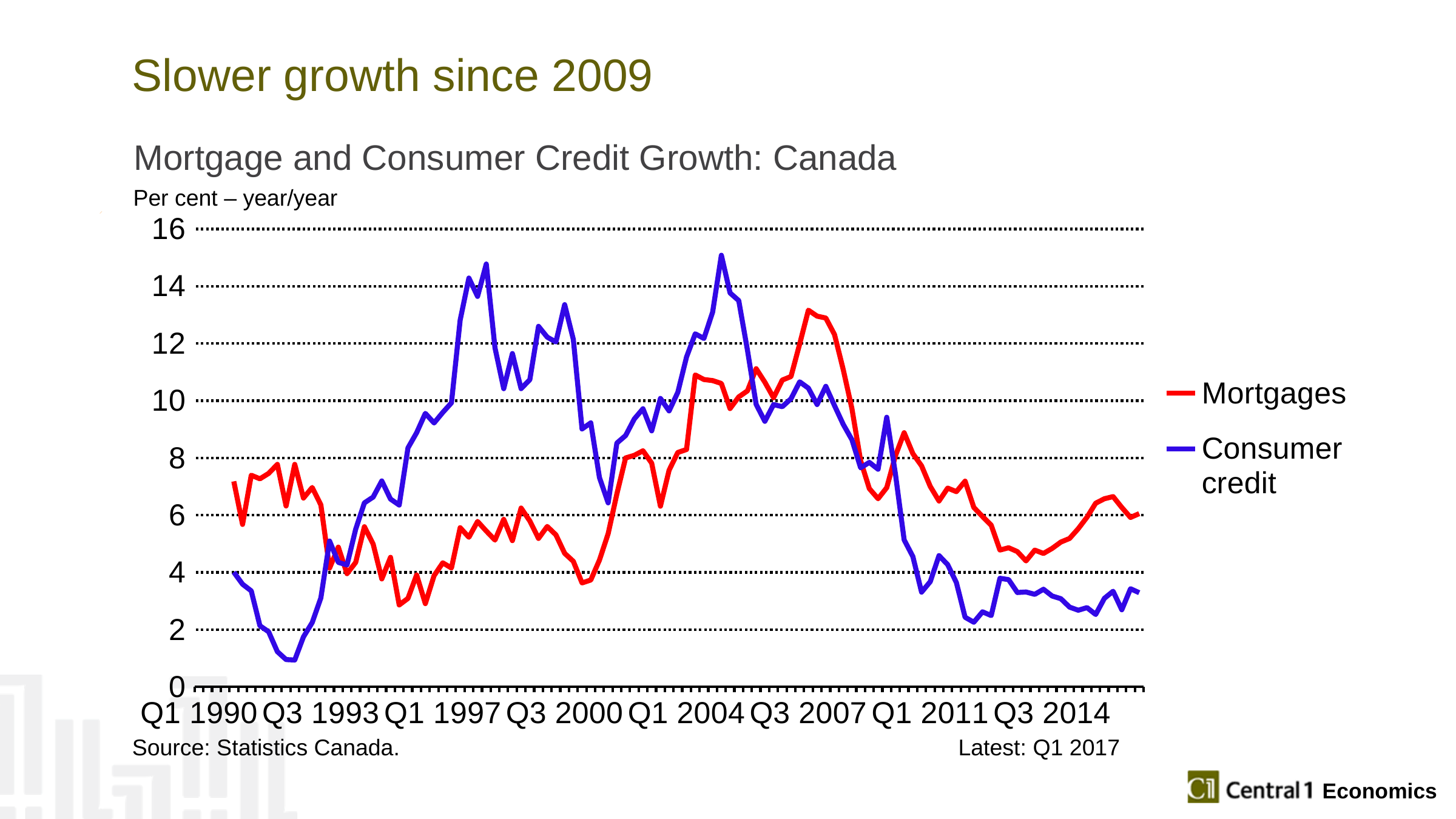
Is the peak value of the Consumer credit line around 2004 greater or less than 14? greater What is the title of the chart? Mortgage and Consumer Credit Growth: Canada Is the value for Consumer credit at Q3 2014 greater or less than 4? less Is the peak value of the Mortgages line around 2007-2008 greater or less than 12? greater At Q1 1997, which series has the higher value, Mortgages or Consumer credit? Consumer credit At Q3 2014, which series has the higher value, Mortgages or Consumer credit? Mortgages Does the Mortgages line rise or fall between Q3 2007 and Q1 2011? Fall Which colour is used for the Consumer credit line? Blue Which series reaches the highest peak on the chart? Consumer credit How many series does the legend list? 2 What kind of chart is shown on the slide? Line chart